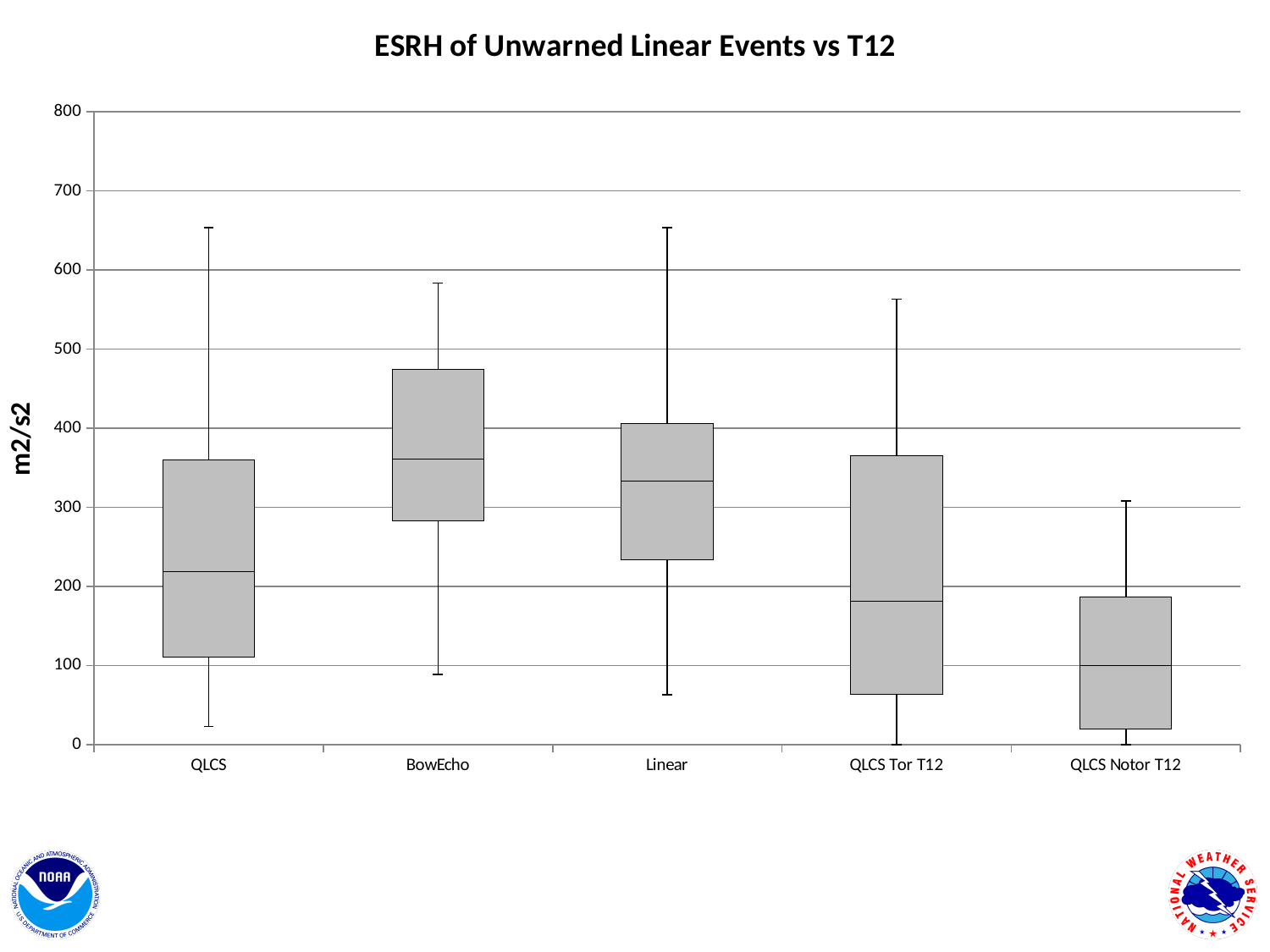
Is the median value for BowEcho greater or less than 300? greater Is the top of the upper whisker for QLCS greater or less than 600? greater Which category has the highest median value? BowEcho What kind of chart is shown on the slide? box plot What is the label on the y axis? m2/s2 Which category has the lowest median value? QLCS Notor T12 What is the title of the chart? ESRH of Unwarned Linear Events vs T12 Is the median value for QLCS greater or less than 200? greater How many categories are shown on the x axis? 5 Which has the larger median value, QLCS or QLCS Notor T12? QLCS